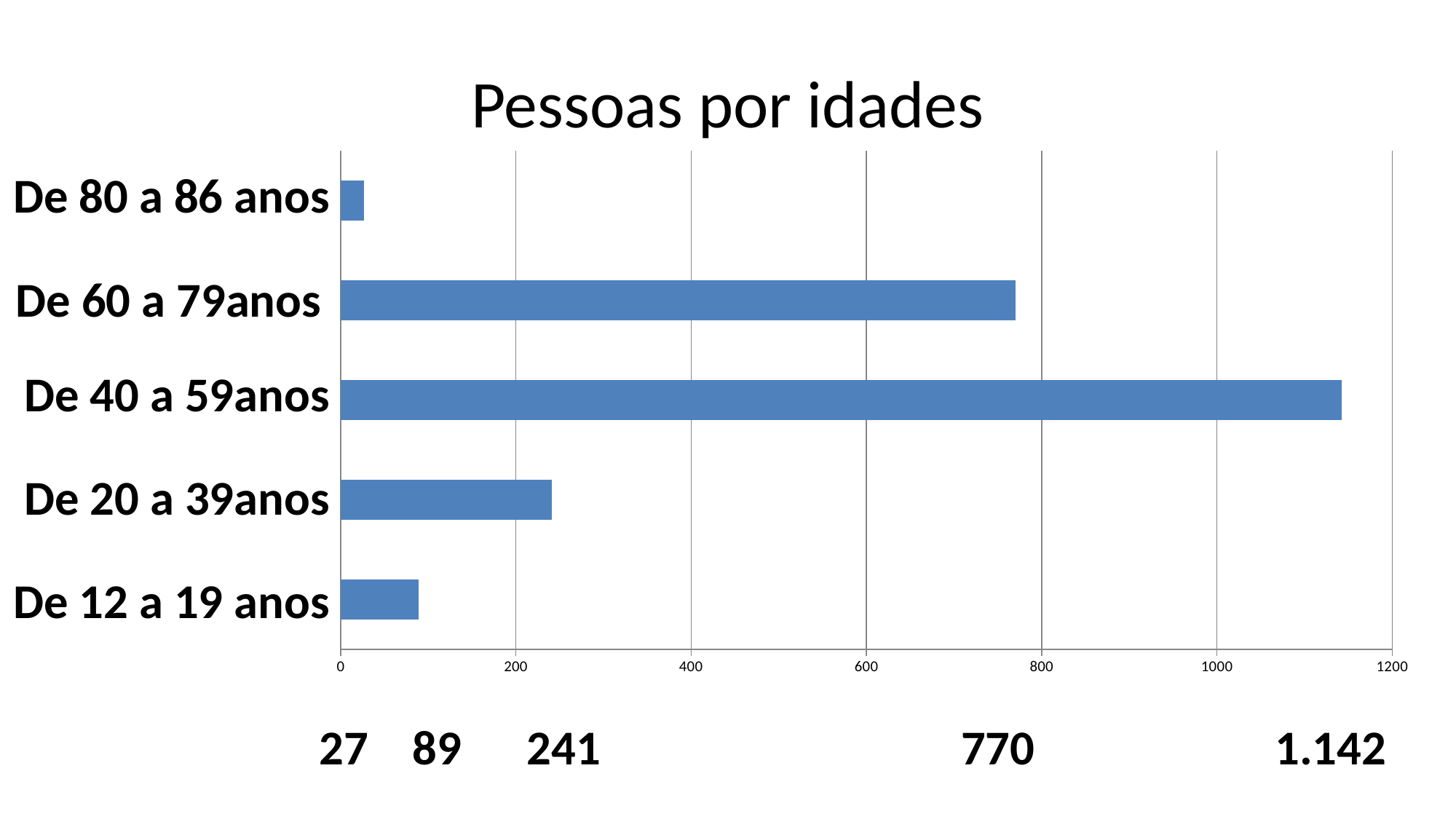
What is the value for De 80 a 86 anos? 27 Is the value for De 60 a 79anos greater or less than 800? less What is the value for De 20 a 39anos? 241 What type of chart is shown on the slide? bar chart What is the value for De 40 a 59anos? 1.142 Which age category has the lowest value? De 80 a 86 anos What is the value for De 12 a 19 anos? 89 How many age categories are shown in the chart? 5 What is the title of the chart? Pessoas por idades Which is larger, the value for De 20 a 39anos or the value for De 12 a 19 anos? De 20 a 39anos What is the value for De 60 a 79anos? 770 Which age category has the highest value? De 40 a 59anos